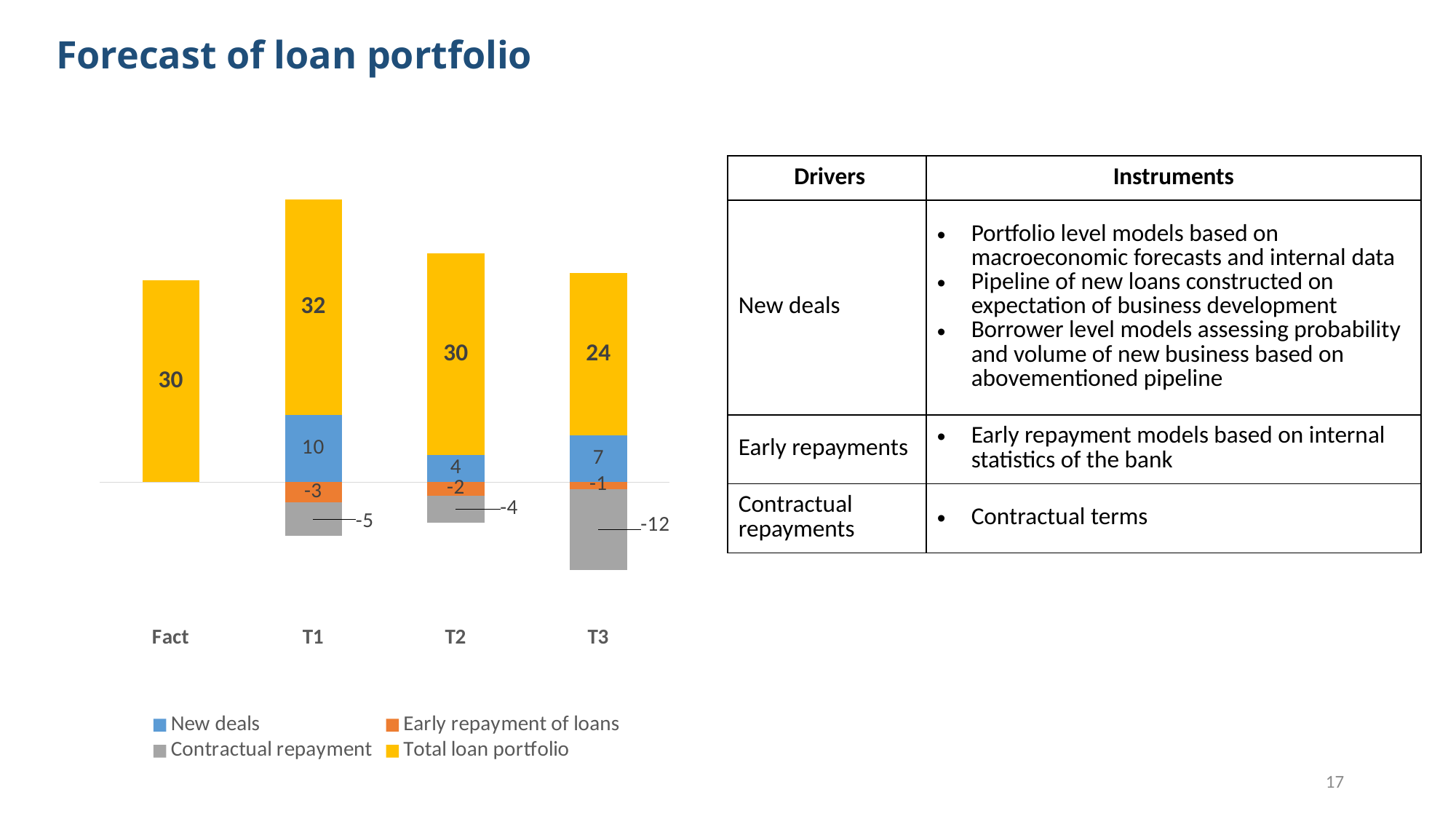
How many series does the legend list? 4 How many periods are shown on the x axis? 4 What is the Contractual repayment value for T2? -4 What is the difference between the Total loan portfolio values for T1 and T3? 8 What is the Early repayment of loans value for T1? -3 Which series is shown in grey in the legend? Contractual repayment Which period has the highest Total loan portfolio value? T1 What is the New deals value for T3? 7 What is the Total loan portfolio value for T1? 32 Which is larger, the New deals value for T1 or for T2? T1 Which period has the lowest Total loan portfolio value? T3 What type of chart is shown on the slide? Stacked bar chart